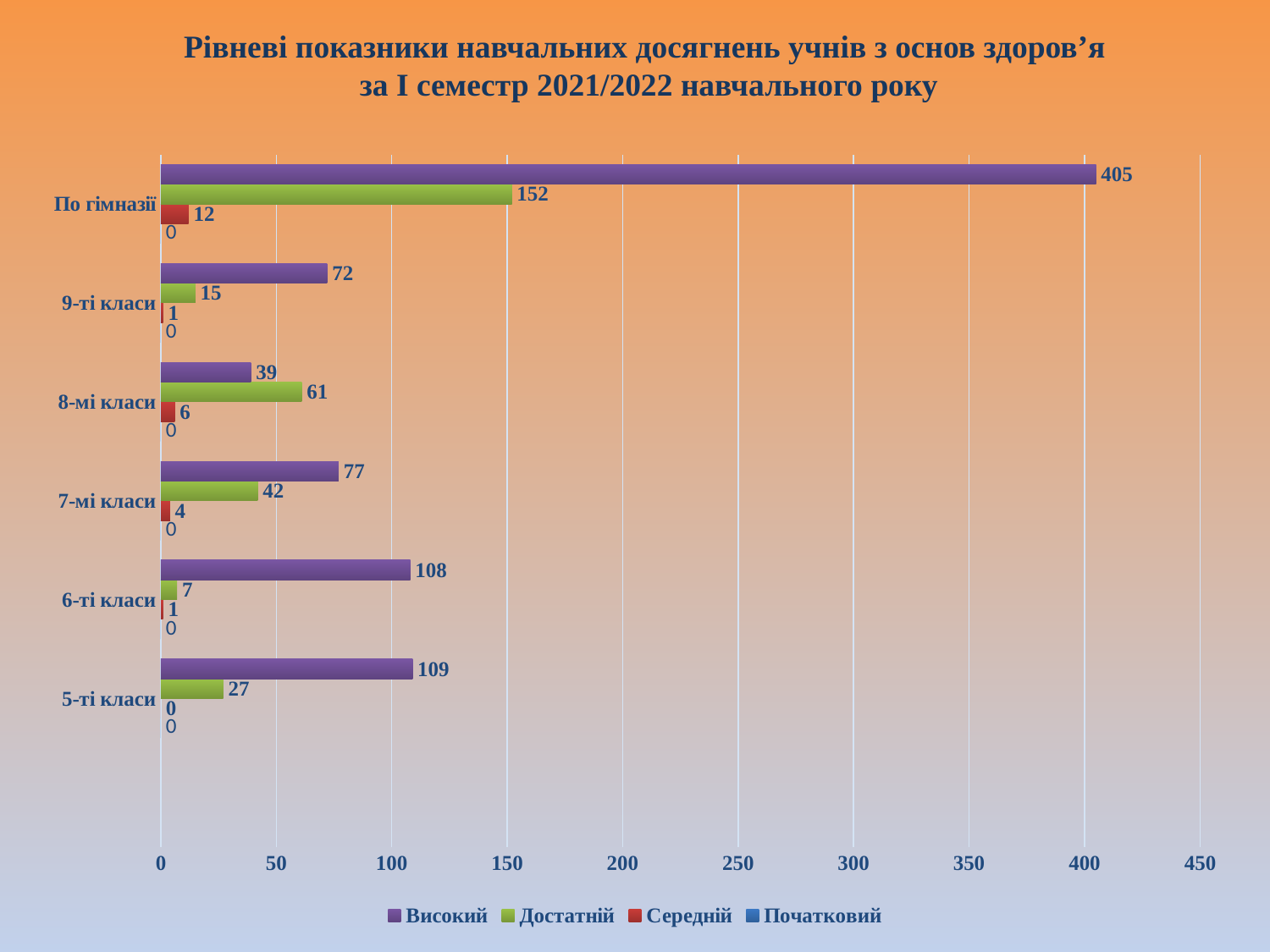
What is the value of Середній for 7-мі класи? 4 Among the class categories (excluding По гімназії), which has the lowest Високий value? 8-мі класи What is the difference between the Високий and Достатній values for 9-ті класи? 57 What is the value of Достатній for 8-мі класи? 61 What is the value of Достатній for 5-ті класи? 27 Which is larger for 8-мі класи: Високий or Достатній? Достатній What is the value of Високий for По гімназії? 405 Which category has the highest Достатній value? По гімназії How many series does the legend list? 4 How many categories are shown on the y axis? 6 What kind of chart is shown on the slide? Bar chart What is the total of Високий, Достатній, Середній and Початковий for 7-мі класи? 123